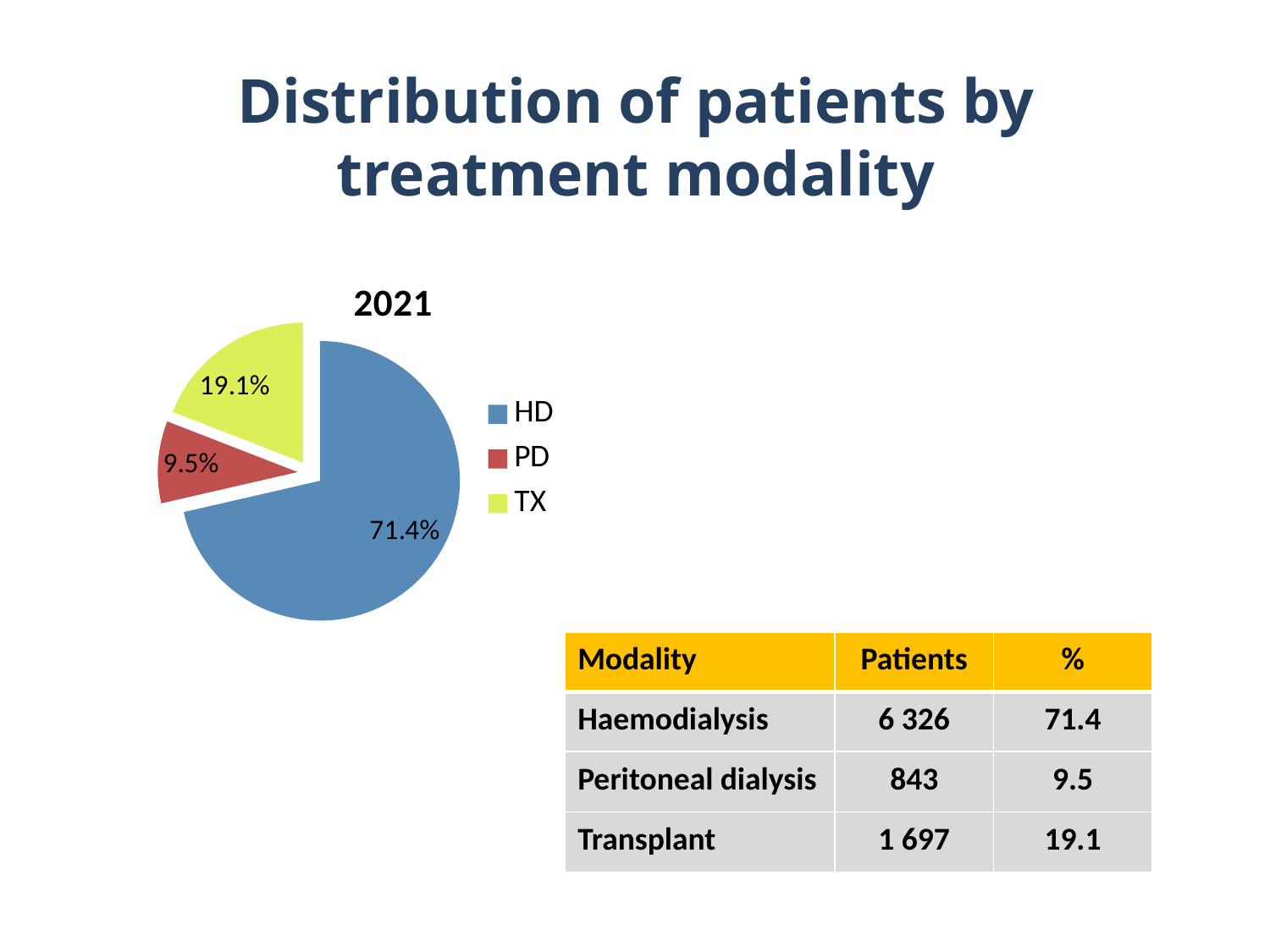
What is the title of the chart? 2021 Which category has the smallest slice of the pie? PD What is the difference in percentage points between the HD and TX slices? 52.3 Which slice is larger, TX or PD? TX Which category has the largest slice of the pie? HD What share of the pie does TX represent? 19.1% What type of chart is shown on the slide? pie chart How many entries does the legend list? 3 What share of the pie does PD represent? 9.5% What colour is the TX slice in the pie chart? yellow-green How many slices does the pie chart have? 3 What share of the pie does HD represent? 71.4%